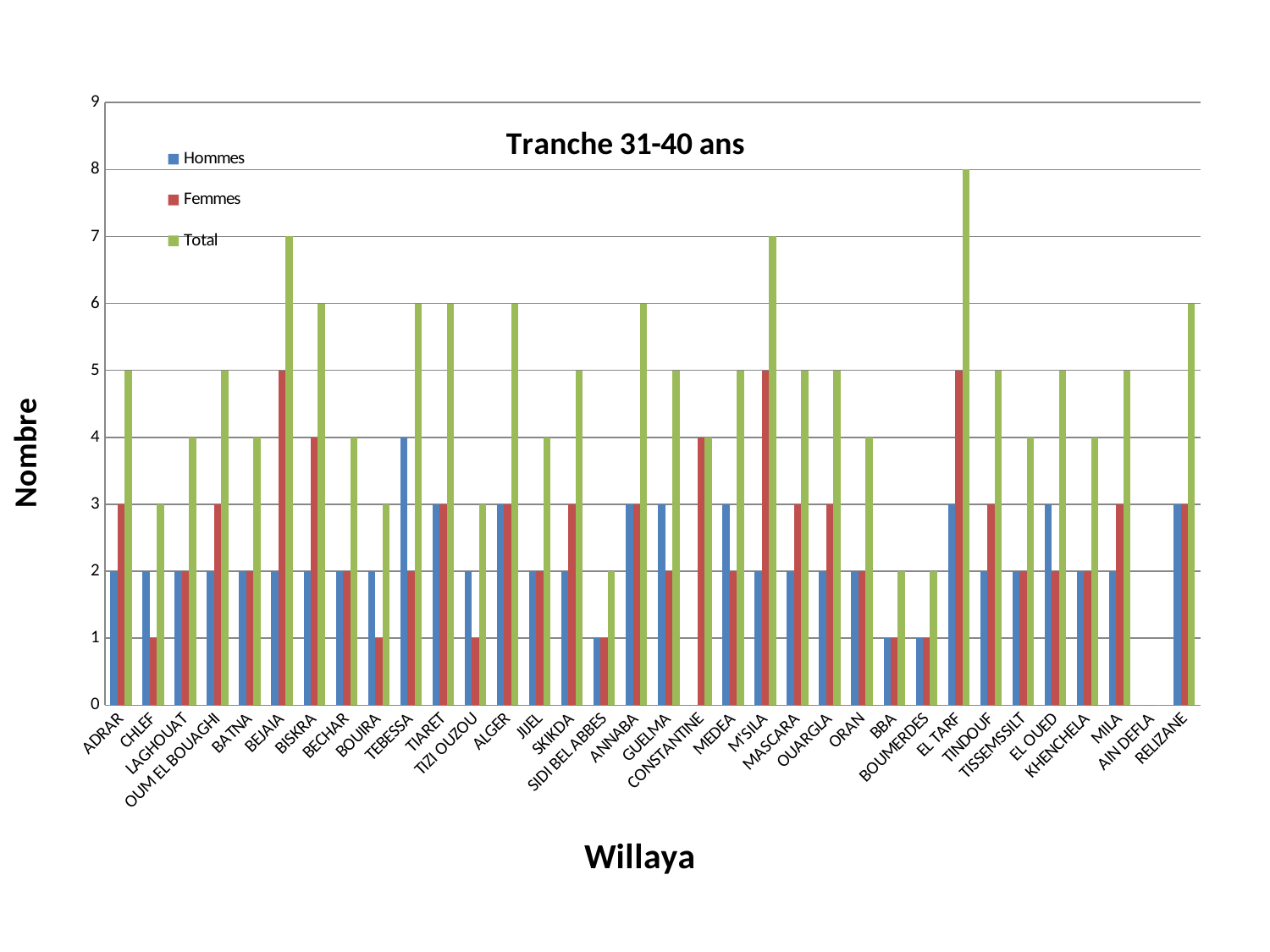
What is the difference between the Total values for EL TARF and SIDI BEL ABBES? 6 Which is larger, the Femmes value for M'SILA or the Femmes value for CHLEF? M'SILA Is the Total value for BEJAIA greater or less than 5? greater What is the Femmes value for BEJAIA? 5 What is the Total value for EL TARF? 8 What is the title of the chart? Tranche 31-40 ans Which willaya has the highest Hommes value? TEBESSA What kind of chart is shown on the slide? bar chart How many series does the legend list? 3 What is the Hommes value for TEBESSA? 4 What is the Femmes value for CONSTANTINE? 4 Which willaya has the highest Total value? EL TARF